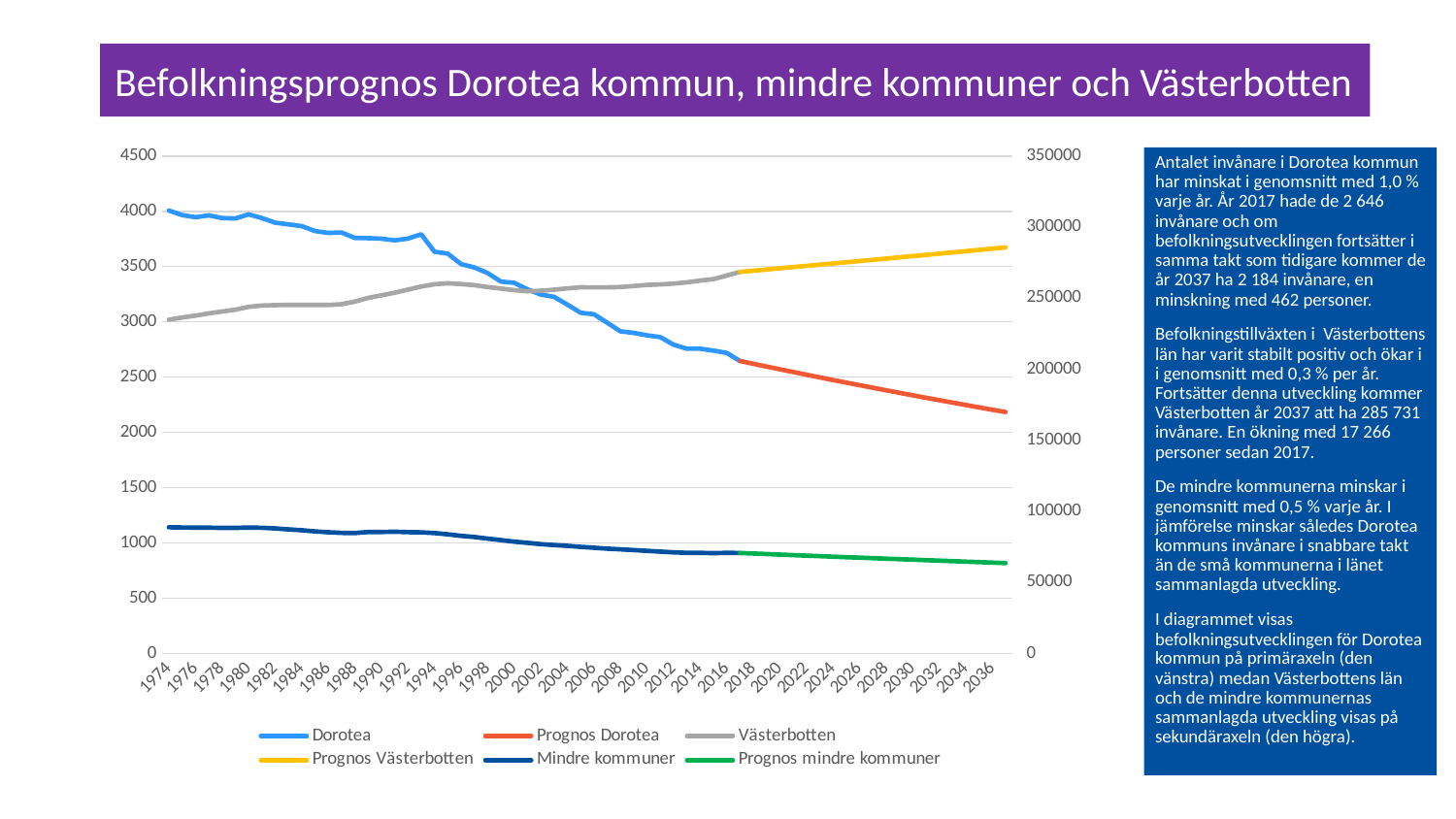
Is the value for Prognos Dorotea in 2036 greater or less than 2500 on the left axis? less Which series is drawn in yellow? Prognos Västerbotten What kind of chart is shown on the slide? line chart Does the Dorotea series rise or fall from 1974 to 2016? fall Which is larger for Dorotea: the value in 1974 or the value in 2016? 1974 How many series does the legend list? 6 Does the Västerbotten series rise or fall from 1974 to 2016? rise Is the value for Dorotea in 2016 greater or less than 3000 on the left axis? less Does the Mindre kommuner series rise or fall from 1974 to 2016? fall Is the value for Mindre kommuner in 1974 greater or less than 50000 on the right axis? greater